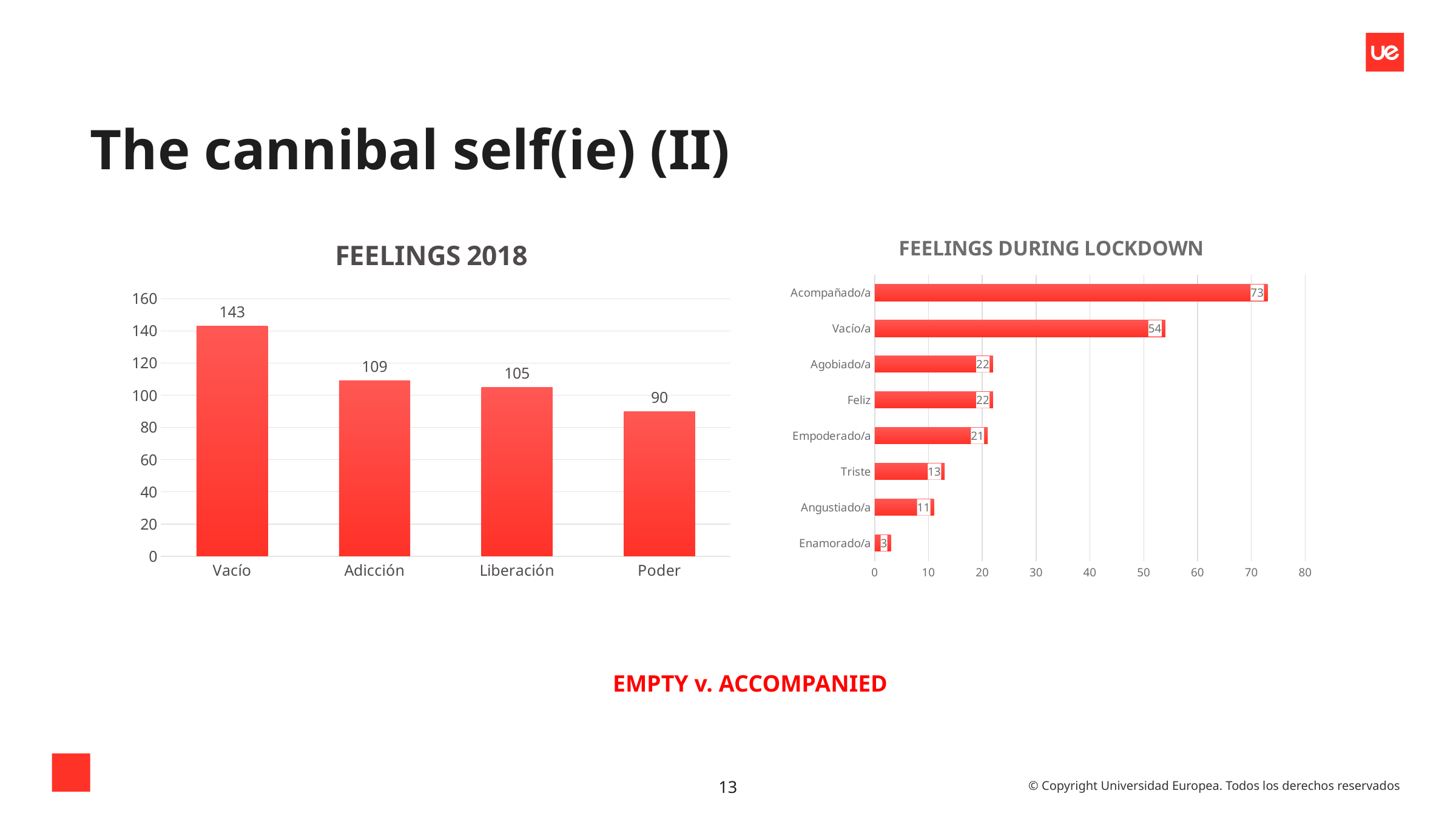
In the FEELINGS 2018 chart, what is the value for Poder? 90 In the FEELINGS DURING LOCKDOWN chart, what is the value for Triste? 13 In the FEELINGS DURING LOCKDOWN chart, which is larger, Vacío/a or Agobiado/a? Vacío/a In the FEELINGS 2018 chart, do the values rise or fall from left to right? fall In the FEELINGS DURING LOCKDOWN chart, how many categories are shown? 8 In the FEELINGS 2018 chart, how many categories are shown? 4 In the FEELINGS DURING LOCKDOWN chart, what is the value for Acompañado/a? 73 In the FEELINGS 2018 chart, which category has the lowest value? Poder In the FEELINGS DURING LOCKDOWN chart, which category has the highest value? Acompañado/a In the FEELINGS 2018 chart, what is the value for Vacío? 143 What kind of chart is the FEELINGS DURING LOCKDOWN chart? bar chart In the FEELINGS 2018 chart, what is the difference between Vacío and Adicción? 34